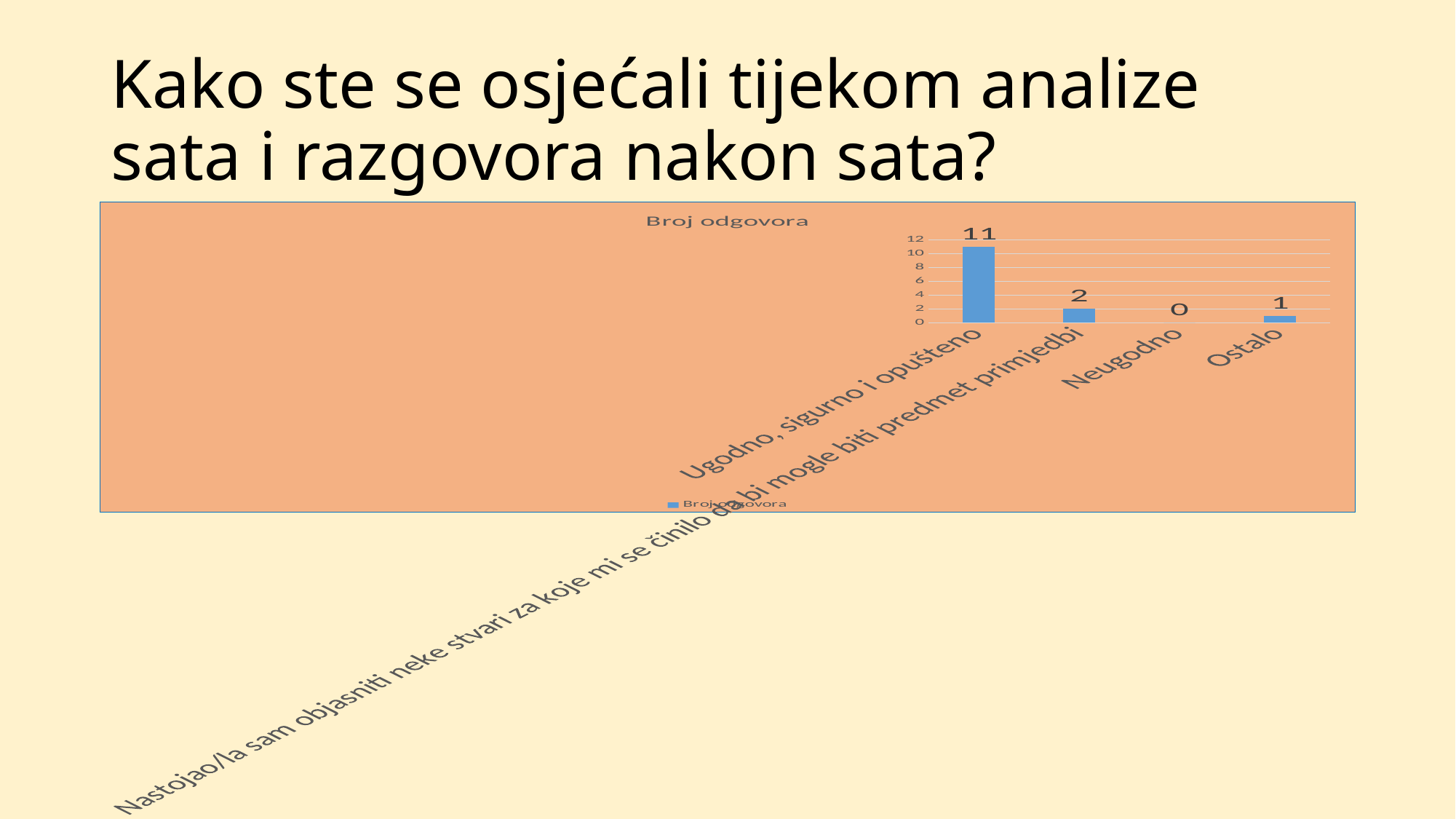
Which is larger, the value for "Ostalo" or the value for "Nastojao/la sam objasniti neke stvari za koje mi se činilo da bi mogle biti predmet primjedbi"? Nastojao/la sam objasniti neke stvari za koje mi se činilo da bi mogle biti predmet primjedbi What kind of chart is shown on the slide? bar chart What is the value for "Nastojao/la sam objasniti neke stvari za koje mi se činilo da bi mogle biti predmet primjedbi"? 2 What is the value for "Ugodno, sigurno i opušteno"? 11 How many categories are shown on the x axis? 4 Which category has the lowest value? Neugodno What is the difference between the values for "Ugodno, sigurno i opušteno" and "Ostalo"? 10 What is the value for "Ostalo"? 1 What is the title of the chart? Broj odgovora Which category has the highest value? Ugodno, sigurno i opušteno What is the value for "Neugodno"? 0 How many series does the legend list? 1